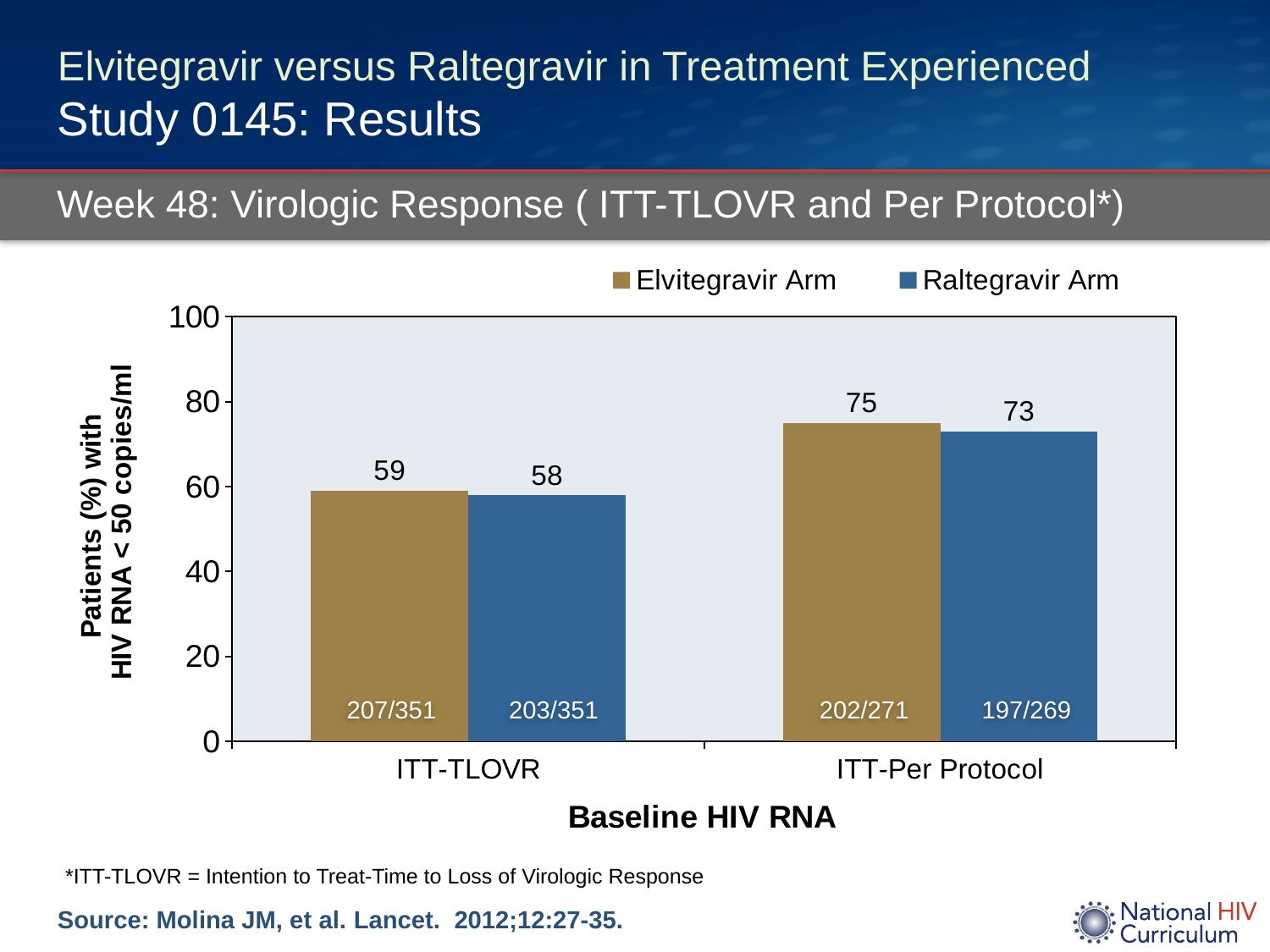
What fraction of patients is printed inside the Elvitegravir Arm bar for ITT-Per Protocol? 202/271 What is the value for the Raltegravir Arm in the ITT-Per Protocol category? 73 Which bar has the lowest value on the chart? Raltegravir Arm, ITT-TLOVR Which bar has the highest value on the chart? Elvitegravir Arm, ITT-Per Protocol What is the difference between the Elvitegravir Arm and Raltegravir Arm values in the ITT-Per Protocol category? 2 What is the value for the Elvitegravir Arm in the ITT-TLOVR category? 59 What kind of chart is shown on the slide? bar chart Is the Raltegravir Arm value for ITT-TLOVR greater or less than 60? less What is the difference between the Elvitegravir Arm value for ITT-Per Protocol and its value for ITT-TLOVR? 16 How many categories are shown on the x axis? 2 How many series does the legend list? 2 What is the value for the Raltegravir Arm in the ITT-TLOVR category? 58